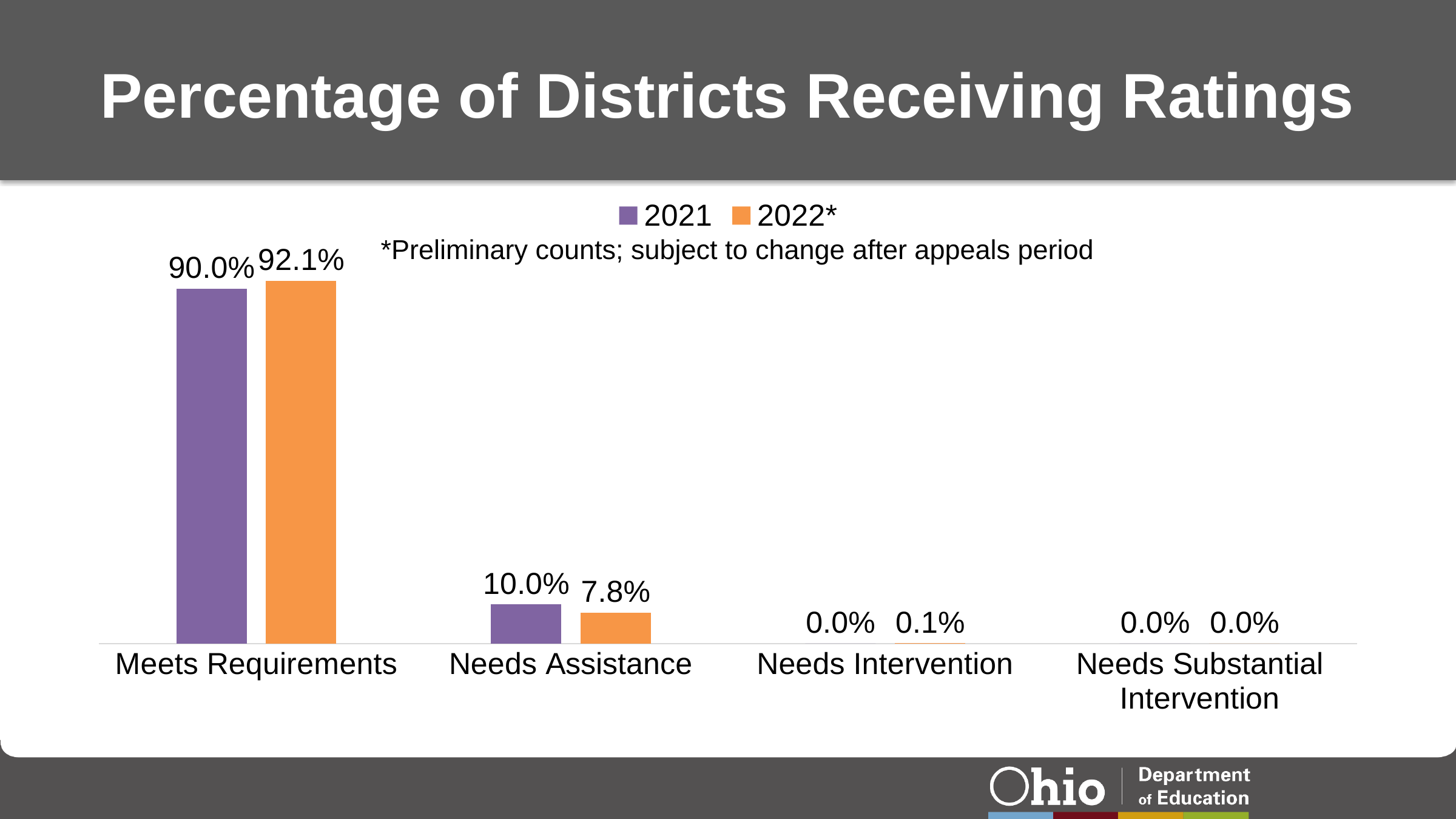
Which category has the highest value for 2021? Meets Requirements What percentage of districts received a Meets Requirements rating in 2022*? 92.1% What is the 2022* value for Needs Intervention? 0.1% How many series does the legend list? 2 What is the 2022* value for Needs Assistance? 7.8% What percentage of districts received a Meets Requirements rating in 2021? 90.0% How many rating categories are shown on the x axis? 4 What is the difference between the 2022* and 2021 values for Meets Requirements? 2.1% Which is larger for Needs Assistance, the 2021 value or the 2022* value? 2021 What colour represents the 2022* series? Orange What kind of chart is shown on the slide? Bar chart What is the difference between the 2021 and 2022* values for Needs Assistance? 2.2%